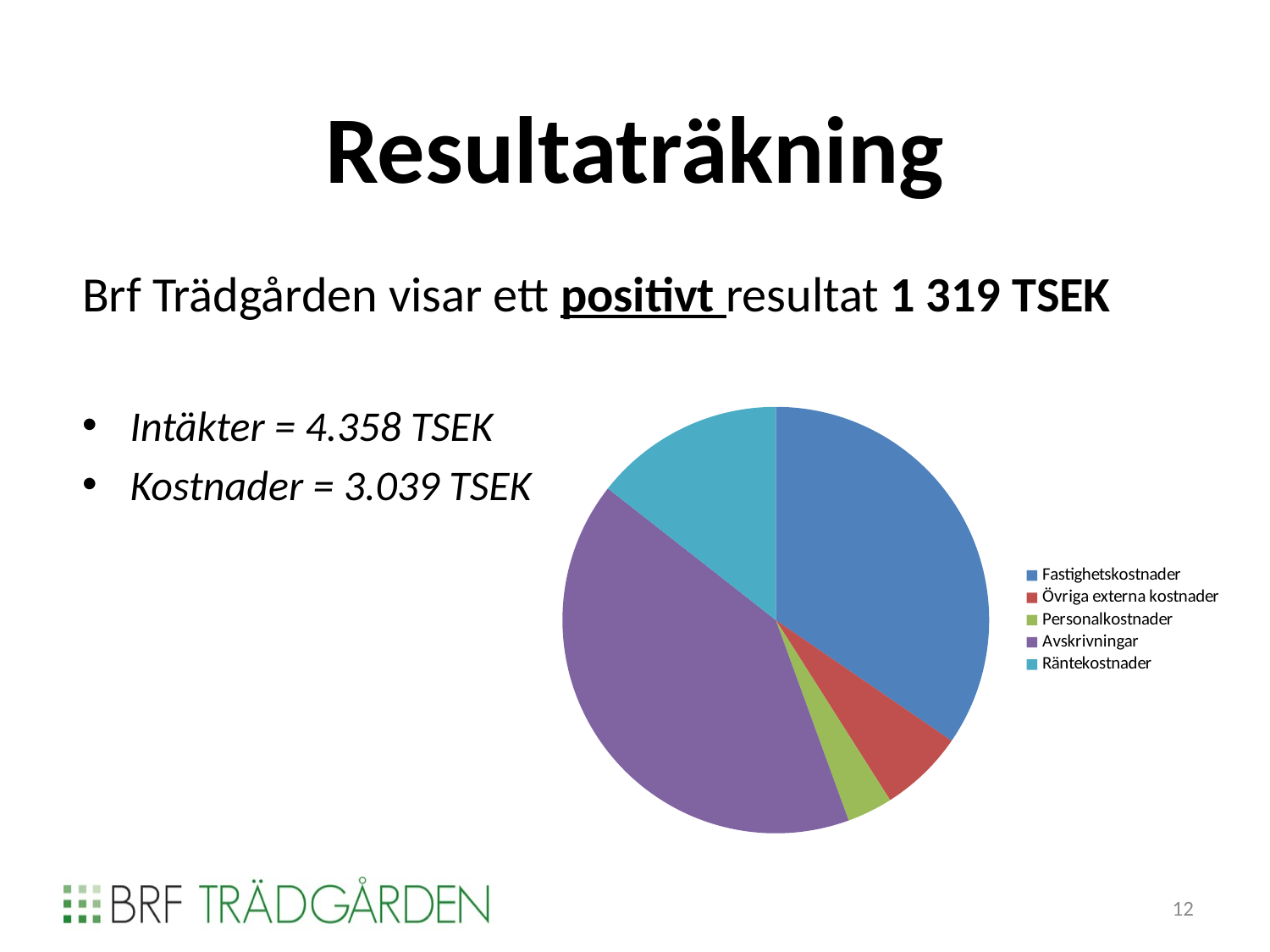
Which slice is larger in the pie chart, Övriga externa kostnader or Personalkostnader? Övriga externa kostnader Which slice is larger in the pie chart, Räntekostnader or Övriga externa kostnader? Räntekostnader How many entries does the legend of the pie chart list? 5 How many slices does the pie chart have? 5 What colour is the Avskrivningar slice in the pie chart? purple Which legend entry is listed first in the pie chart's legend? Fastighetskostnader Which slice is larger in the pie chart, Fastighetskostnader or Räntekostnader? Fastighetskostnader Which category has the smallest slice in the pie chart? Personalkostnader What kind of chart is shown on the slide? pie chart Which category has the largest slice in the pie chart? Avskrivningar